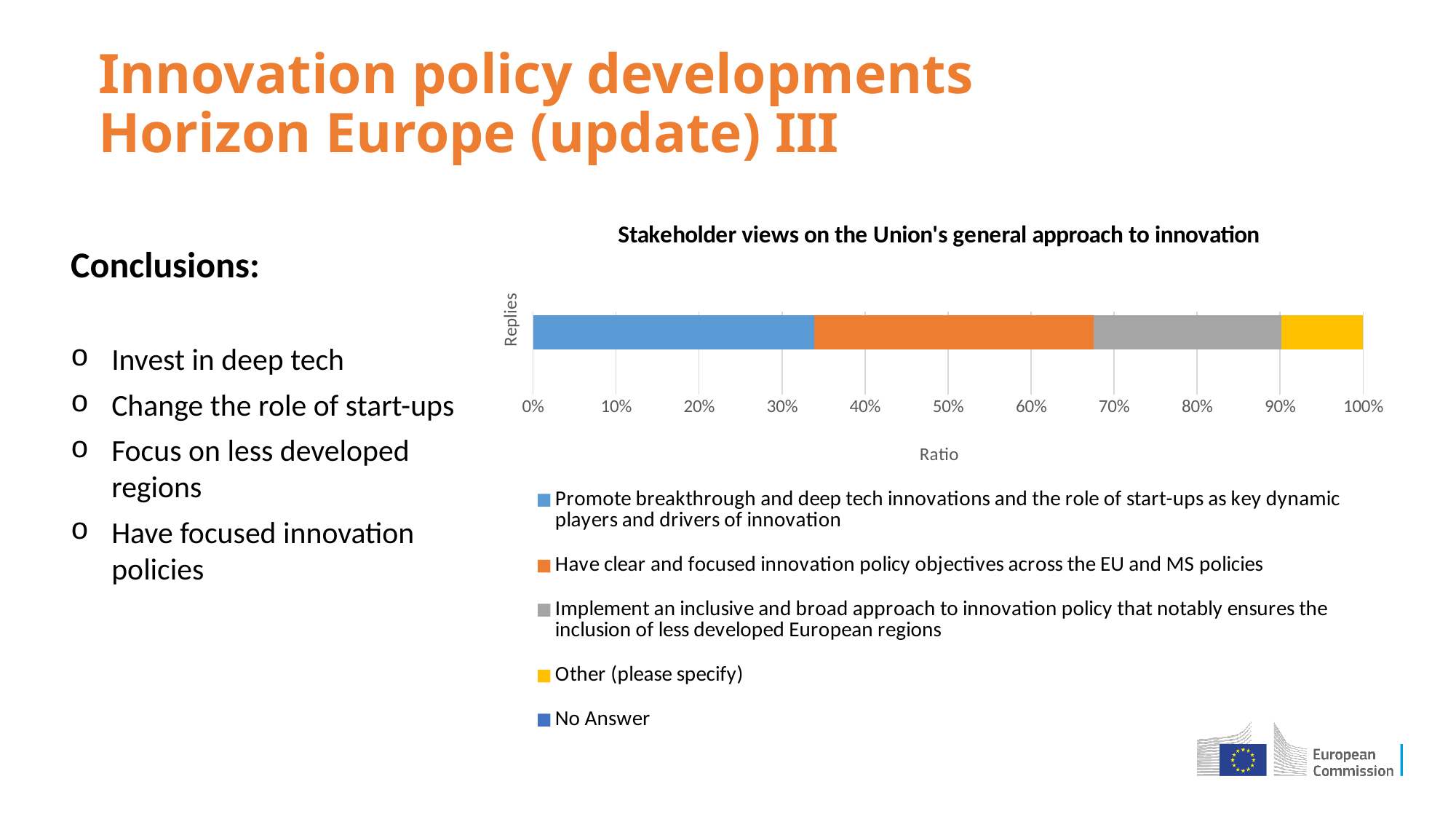
Is the share for 'Promote breakthrough and deep tech innovations and the role of start-ups as key dynamic players and drivers of innovation' greater or less than 30%? greater Which is larger in the bar: the share for 'Implement an inclusive and broad approach to innovation policy...' or the share for 'Other (please specify)'? Implement an inclusive and broad approach to innovation policy that notably ensures the inclusion of less developed European regions What is the title of the chart? Stakeholder views on the Union's general approach to innovation What is the label on the horizontal axis of the chart? Ratio Which is larger in the bar: the share for 'Promote breakthrough and deep tech innovations...' or the share for 'Implement an inclusive and broad approach to innovation policy...'? Promote breakthrough and deep tech innovations and the role of start-ups as key dynamic players and drivers of innovation Is the share for 'Other (please specify)' greater or less than 20%? less Is the share for 'Implement an inclusive and broad approach to innovation policy that notably ensures the inclusion of less developed European regions' greater or less than 30%? less How many series does the chart legend list? 5 How many bars are plotted in the chart? 1 What kind of chart is shown on the slide? Stacked bar chart